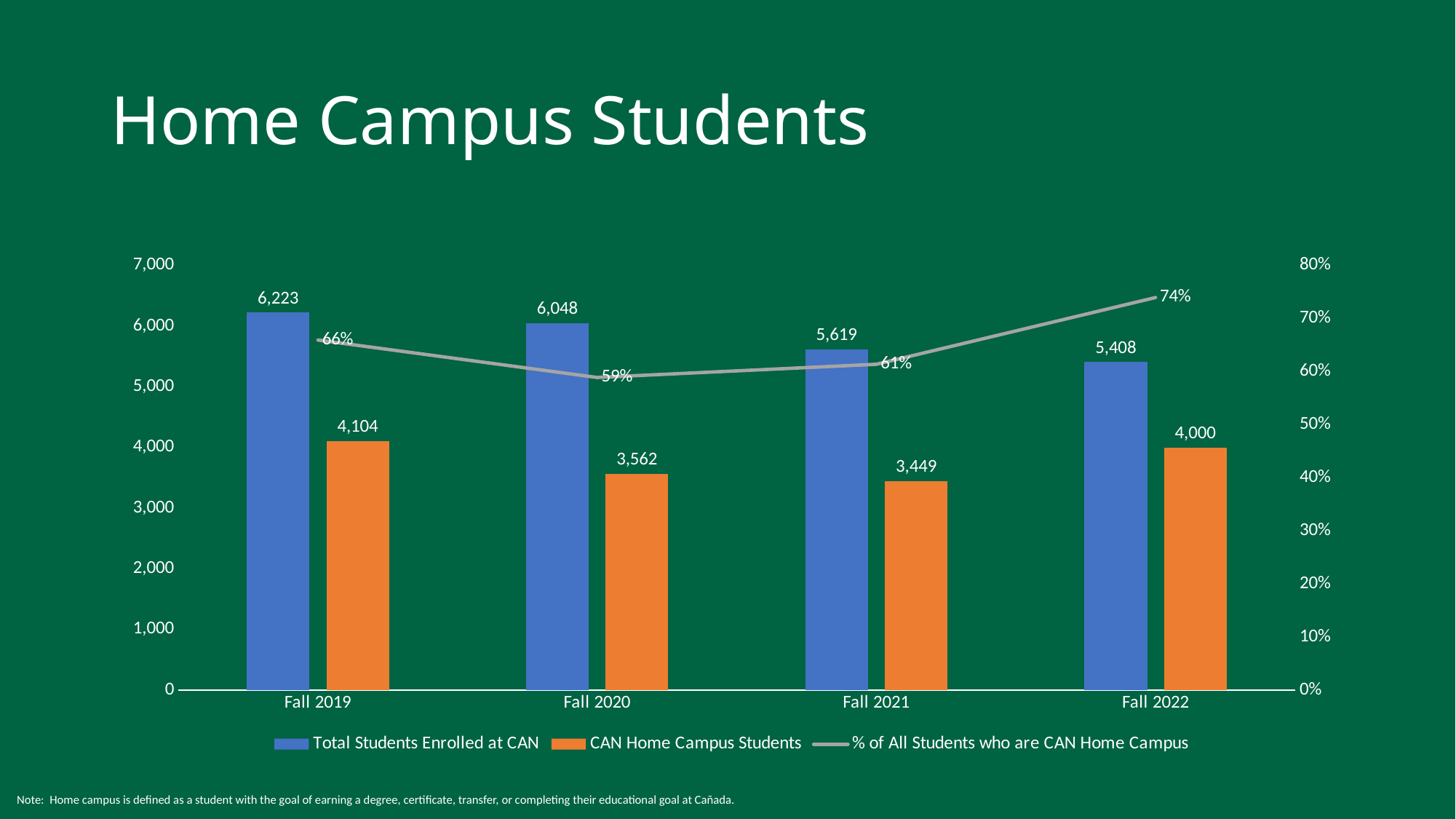
Which is larger: CAN Home Campus Students in Fall 2020 or in Fall 2021? Fall 2020 What colour are the bars for CAN Home Campus Students? orange How many terms are shown on the x axis? 4 In which term is CAN Home Campus Students highest? Fall 2019 In which term is the % of All Students who are CAN Home Campus highest? Fall 2022 Does Total Students Enrolled at CAN rise or fall from Fall 2019 to Fall 2022? fall What is the difference between Total Students Enrolled at CAN and CAN Home Campus Students in Fall 2021? 2,170 What is the value for Total Students Enrolled at CAN in Fall 2019? 6,223 In which term is Total Students Enrolled at CAN lowest? Fall 2022 What is the % of All Students who are CAN Home Campus in Fall 2020? 59% What is the value for CAN Home Campus Students in Fall 2022? 4,000 How many series does the legend list? 3